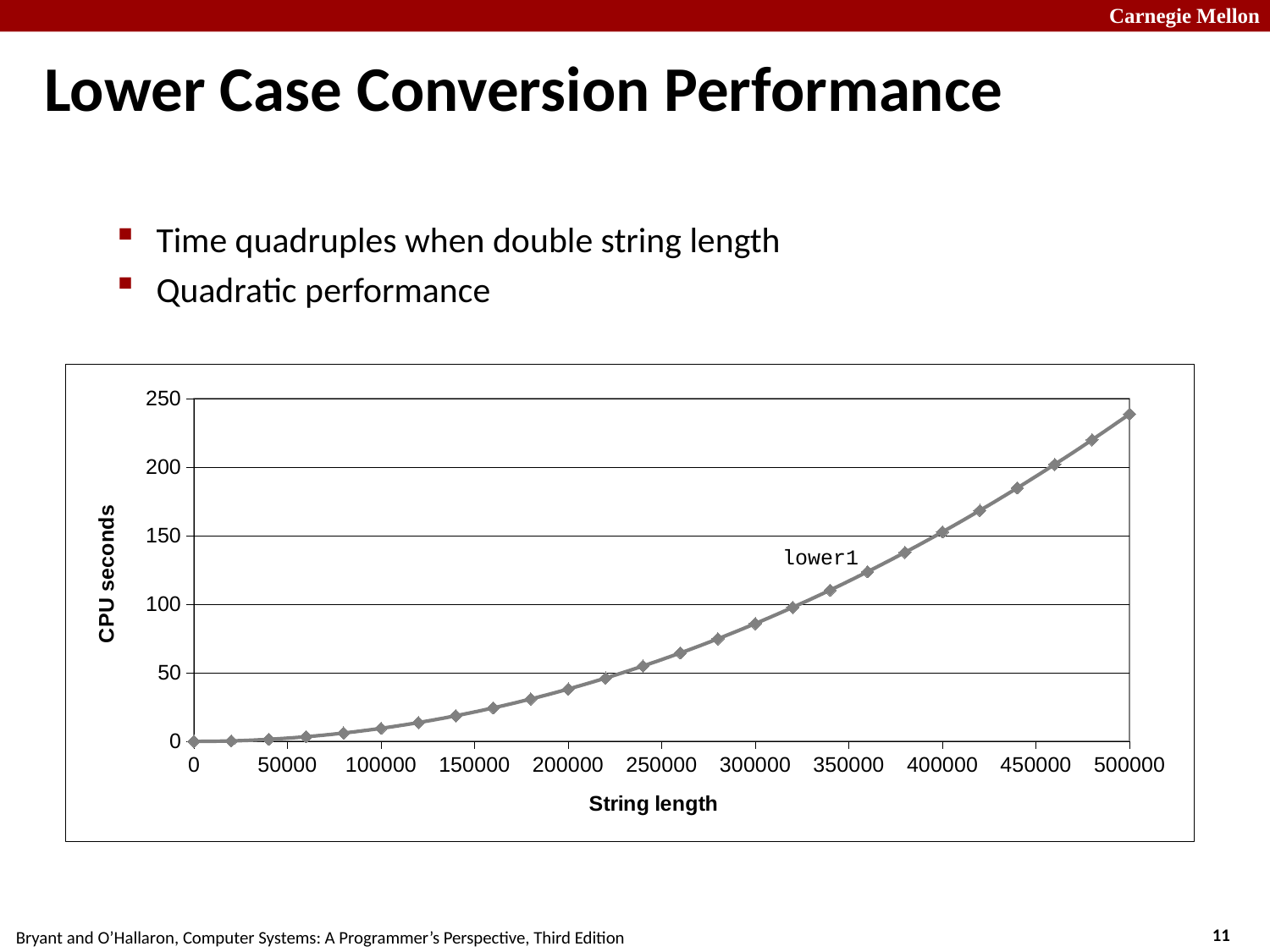
What kind of chart is shown on the slide? line chart Is the CPU seconds value at string length 200000 greater or less than 50? less What is the title of the x axis of the chart? String length How many series are plotted in the chart? 1 What is the name of the series plotted in the chart? lower1 Which has a larger CPU seconds value: string length 400000 or string length 200000? 400000 Do the CPU seconds rise or fall as string length increases? rise At which string length is the CPU seconds value highest? 500000 Is the CPU seconds value at string length 300000 greater or less than 100? less Is the CPU seconds value at string length 500000 greater or less than 200? greater What is the title of the y axis of the chart? CPU seconds At which string length is the CPU seconds value lowest? 0